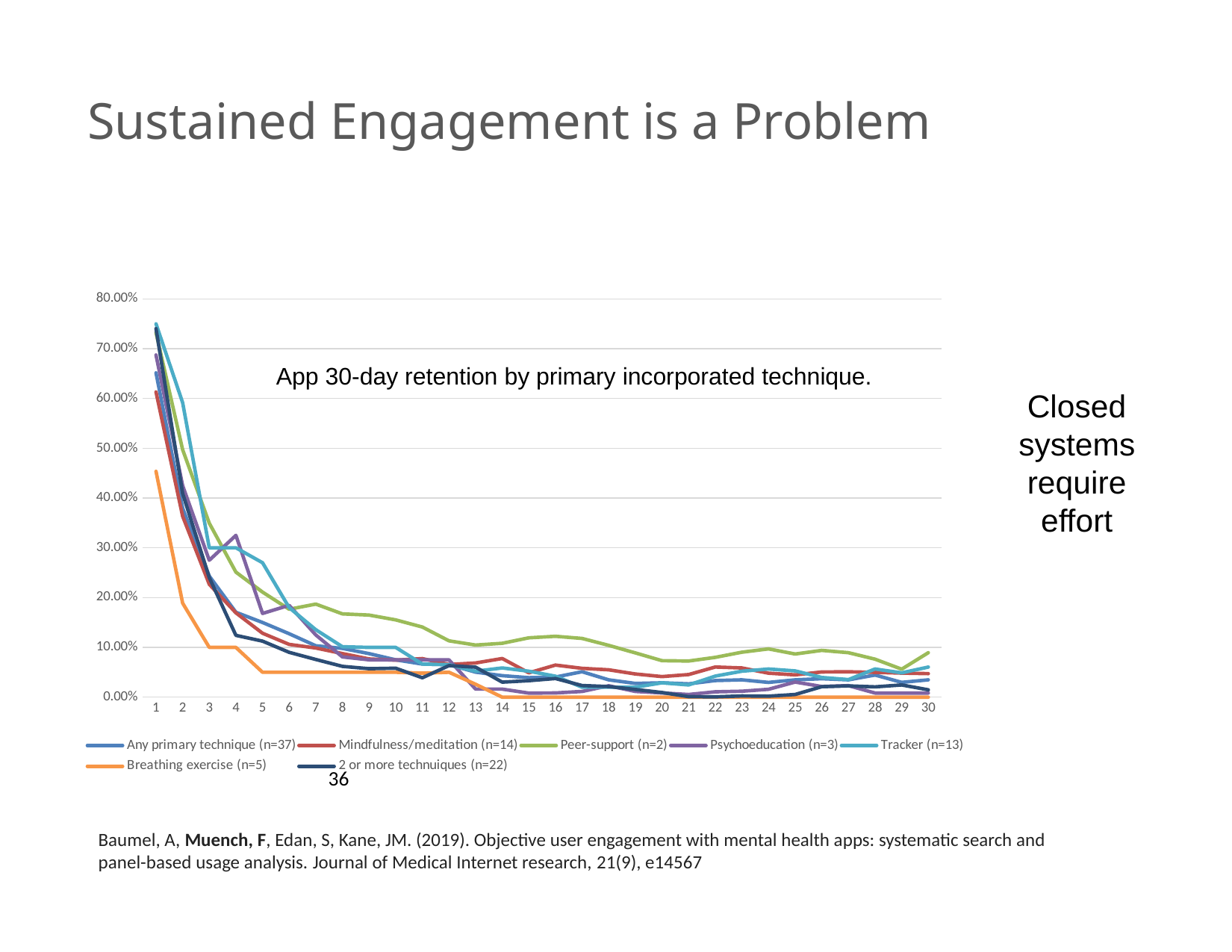
Is the value for Peer-support (n=2) at day 30 greater or less than 10.00%? less At day 20, which series has the larger value: Peer-support (n=2) or Breathing exercise (n=5)? Peer-support (n=2) Which series has the lowest value at day 1? Breathing exercise (n=5) Do the retention values generally rise or fall from day 1 to day 30? fall Is the value for Breathing exercise (n=5) at day 1 greater or less than 50.00%? less Which legend entry has n=2? Peer-support (n=2) What is the title shown inside the chart area? App 30-day retention by primary incorporated technique. Is the value for Tracker (n=13) at day 1 greater or less than 70.00%? greater How many series does the chart's legend list? 7 How many points (days) are shown along the x axis of the chart? 30 What kind of chart is shown on the slide? line chart Which series has the highest value at day 30? Peer-support (n=2)